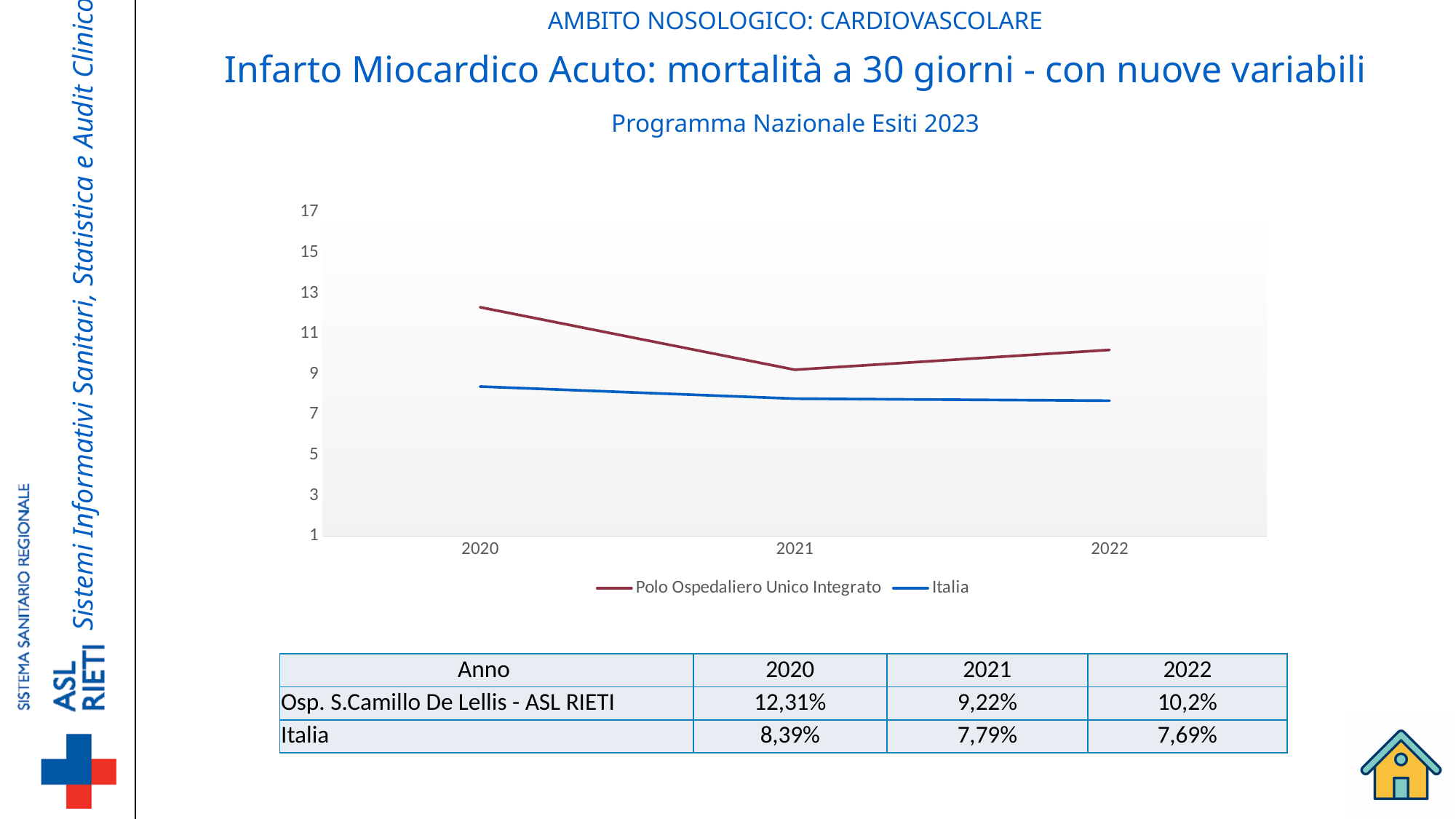
Is the value for Polo Ospedaliero Unico Integrato in 2020 greater or less than 11? greater How many series does the chart legend list? 2 Which series is plotted with the blue line in the chart? Italia According to the table below the chart, what is the value for Osp. S.Camillo De Lellis - ASL RIETI in 2021? 9,22% In which year does the Polo Ospedaliero Unico Integrato line reach its highest value? 2020 In which year does the Polo Ospedaliero Unico Integrato line reach its lowest value? 2021 What kind of chart is shown on the slide? line chart According to the table below the chart, what is the value for Italia in 2022? 7,69% According to the table below the chart, what is the value for Italia in 2020? 8,39% Does the Italia line rise or fall from 2020 to 2022? fall In 2020, which series has the higher value, Polo Ospedaliero Unico Integrato or Italia? Polo Ospedaliero Unico Integrato How many years are plotted along the x axis of the chart? 3